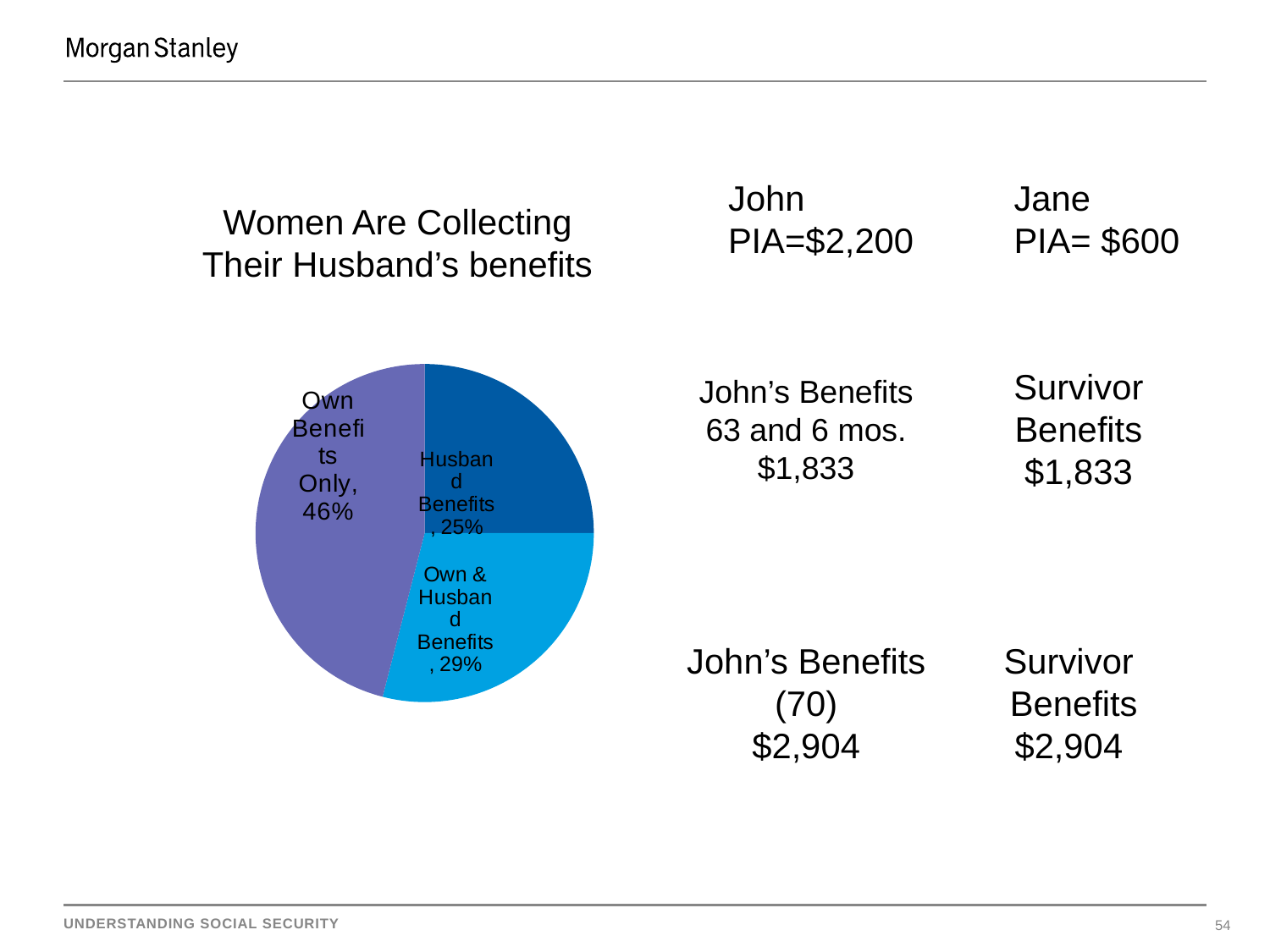
What share of the pie is labelled Own Benefits Only? 46% How many slices does the pie chart have? 3 Which is larger, the Own & Husband Benefits slice or the Husband Benefits slice? Own & Husband Benefits What is the difference in percentage points between the Own & Husband Benefits slice and the Husband Benefits slice? 4 What is the difference in percentage points between the Own Benefits Only slice and the Husband Benefits slice? 21 Which slice of the pie is the largest? Own Benefits Only What colour is the Own Benefits Only slice? purple Which slice of the pie is the smallest? Husband Benefits What kind of chart is shown on the slide? pie chart What share of the pie is labelled Husband Benefits? 25% What is the title of the pie chart? Women Are Collecting Their Husband's benefits What share of the pie is labelled Own & Husband Benefits? 29%